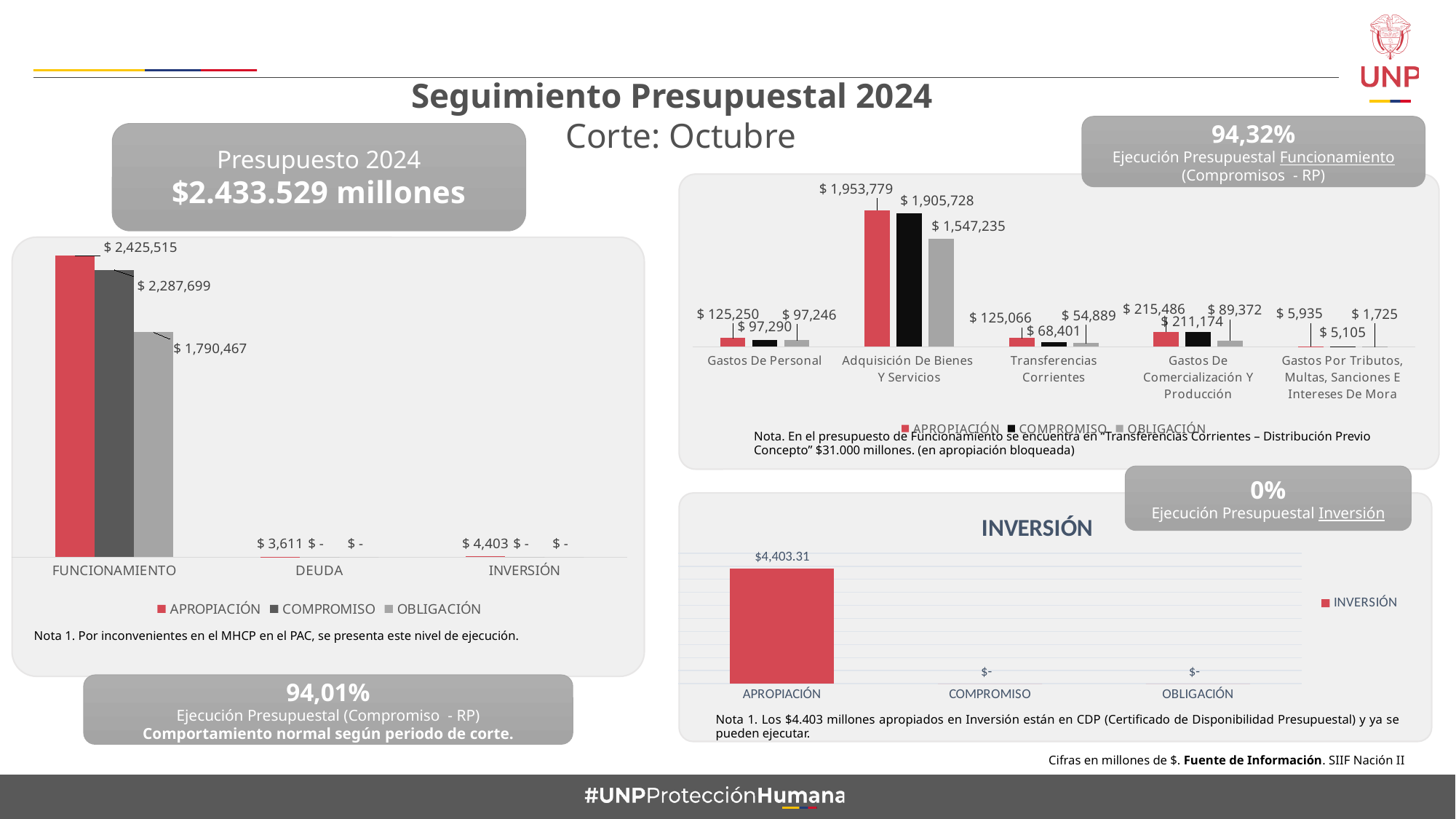
In the left chart, what is the OBLIGACIÓN value for FUNCIONAMIENTO? $ 1,790,467 In the top-right chart, what is the OBLIGACIÓN value for Transferencias Corrientes? $ 54,889 In the top-right chart, how many series does the legend list? 3 In the INVERSIÓN chart, what is the value for APROPIACIÓN? $4,403.31 In the top-right chart, is the APROPIACIÓN value for Gastos De Personal larger or smaller than the APROPIACIÓN value for Gastos De Comercialización Y Producción? smaller In the left chart, what is the APROPIACIÓN value for FUNCIONAMIENTO? $ 2,425,515 In the top-right chart, what is the COMPROMISO value for Adquisición De Bienes Y Servicios? $ 1,905,728 In the left chart, which category has the highest APROPIACIÓN value? FUNCIONAMIENTO In the top-right chart, which category has the lowest APROPIACIÓN value? Gastos Por Tributos, Multas, Sanciones E Intereses De Mora What type of chart is the INVERSIÓN chart? bar chart In the left chart, how many categories are shown on the x axis? 3 In the left chart, what is the difference between the APROPIACIÓN and COMPROMISO values for FUNCIONAMIENTO? $ 137,816